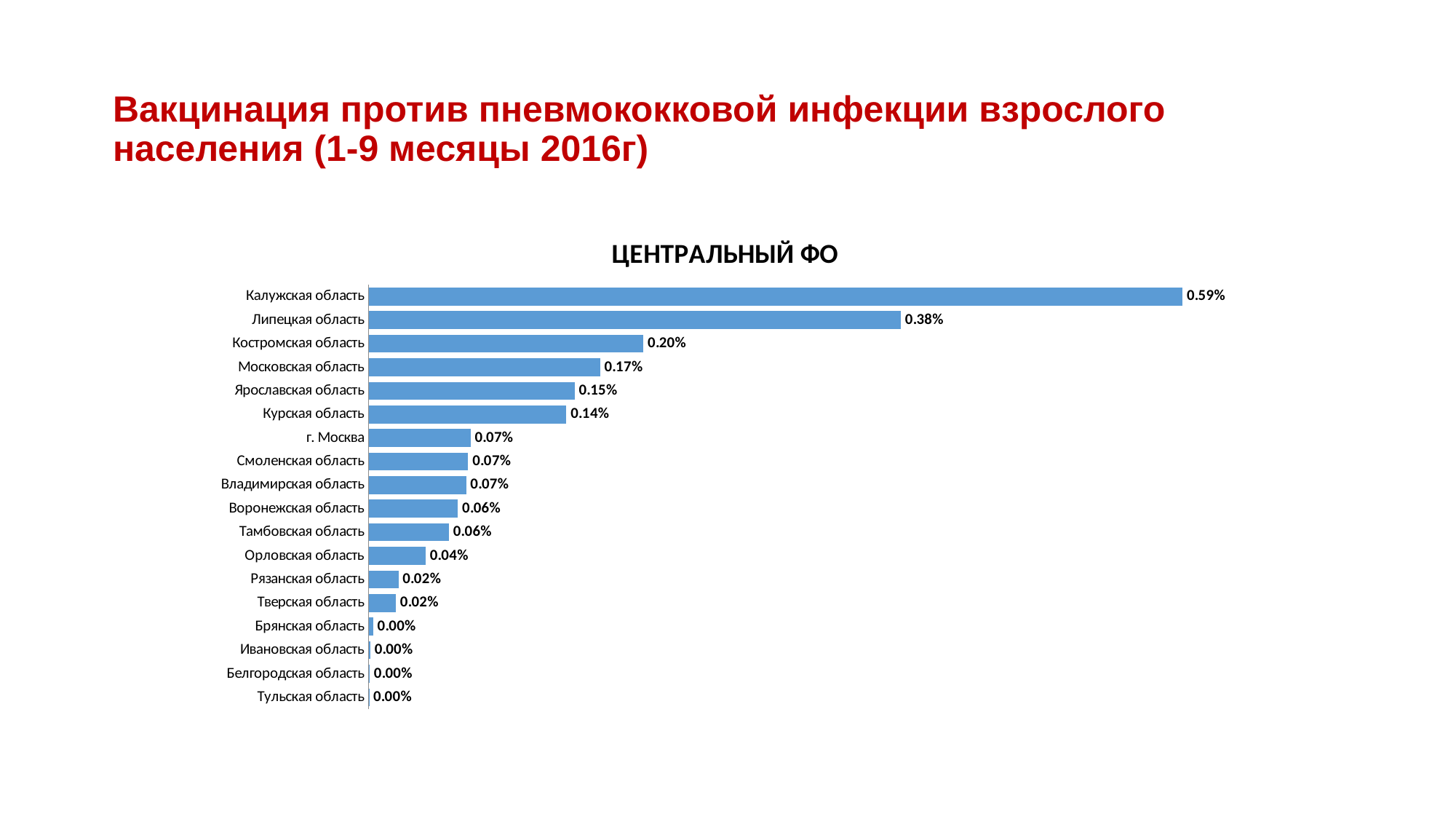
What is the value for Липецкая область? 0.38% What is the chart's title? ЦЕНТРАЛЬНЫЙ ФО What is the value for г. Москва? 0.07% Which has the larger value, Московская область or Ярославская область? Московская область How many regions have a value of 0.00%? 4 What type of chart is shown on the slide? bar chart What is the value for Орловская область? 0.04% How many regions are shown in the chart? 18 Which region has the highest value? Калужская область What is the value for Московская область? 0.17% What is the value for Калужская область? 0.59% What is the difference between the values for Калужская область and Липецкая область? 0.21%